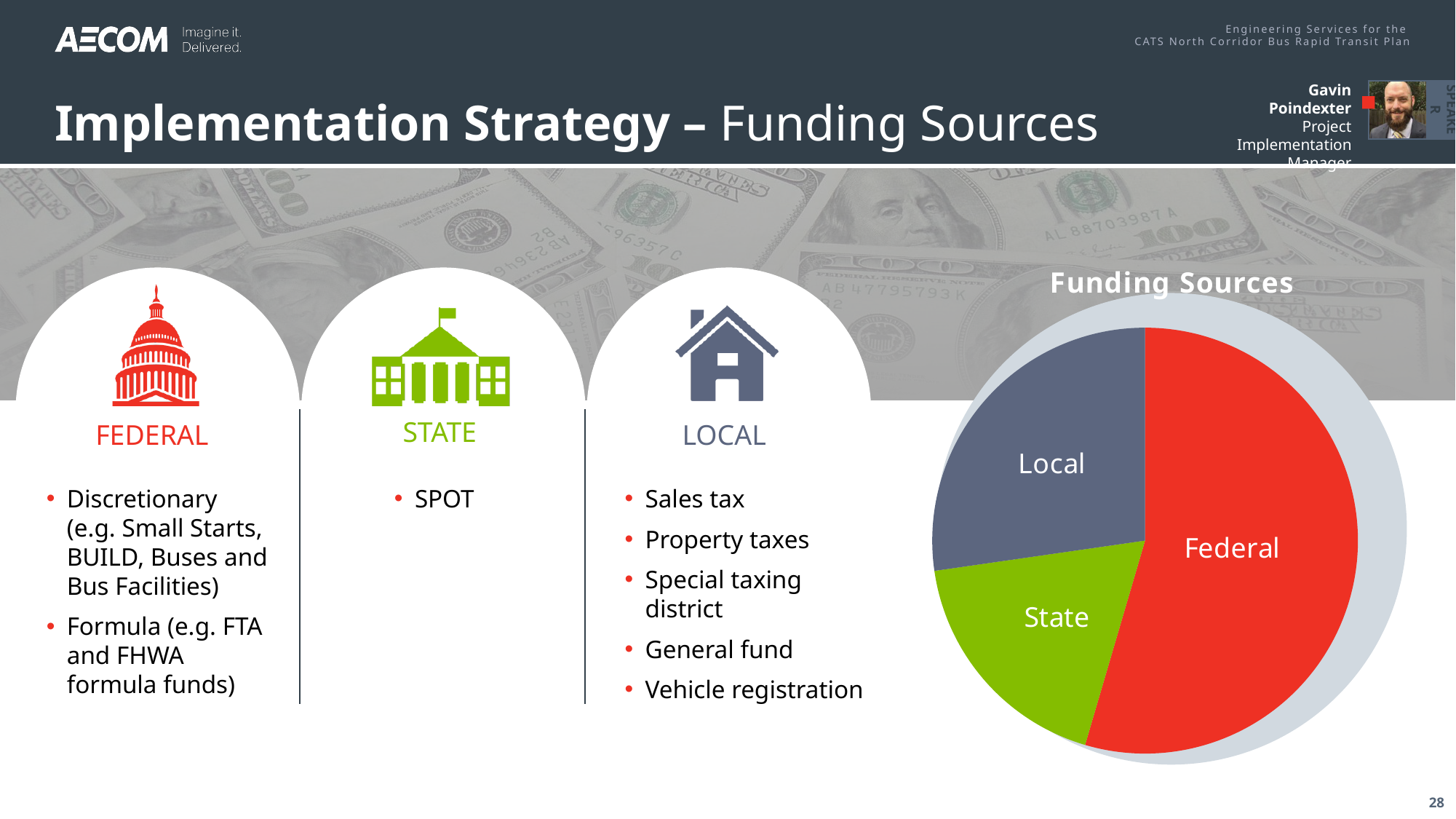
Does the Federal slice take up more or less than half of the pie chart? more What colour is the Federal slice of the pie chart? red Which funding source has the largest slice of the pie chart? Federal Which slice is larger in the pie chart, Local or State? Local How many slices does the pie chart have? 3 Which slice is larger in the pie chart, Federal or Local? Federal What is the title of the chart? Funding Sources What kind of chart is shown on the slide? pie chart Which funding source has the smallest slice of the pie chart? State